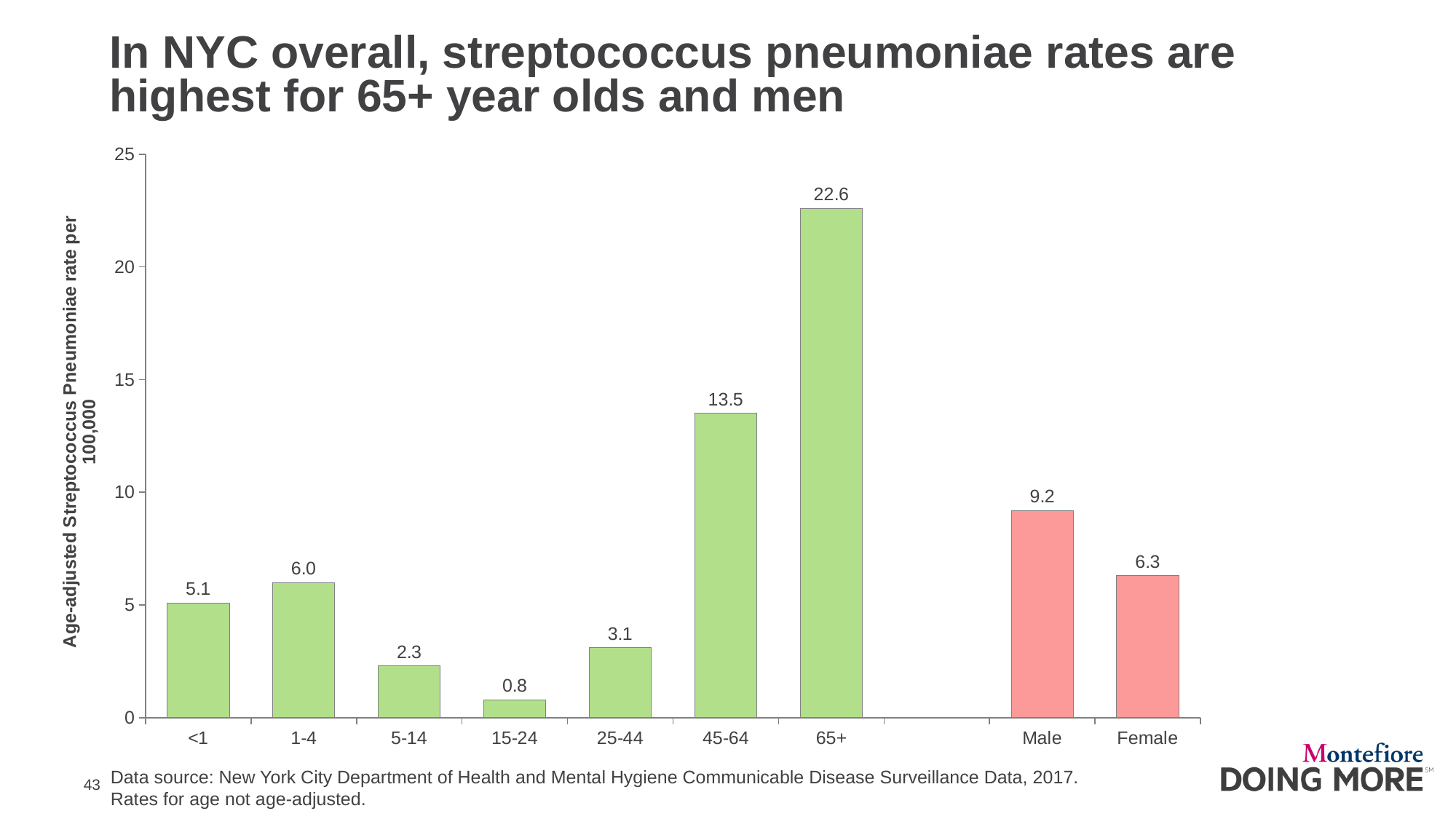
Which has a higher rate, the 1-4 age group or the 5-14 age group? 1-4 What is the streptococcus pneumoniae rate for the 65+ age group? 22.6 What is the rate for Male? 9.2 Is the value for the 45-64 age group greater or less than 10? greater What kind of chart is shown on the slide? bar chart What is the difference between the rates for Male and Female? 2.9 Which age group has the highest streptococcus pneumoniae rate? 65+ How many bars are plotted on the chart? 9 What colour are the Male and Female bars? pink/red What is the rate for the 15-24 age group? 0.8 What is the difference between the rates for the 65+ and 45-64 age groups? 9.1 Which age group has the lowest streptococcus pneumoniae rate? 15-24